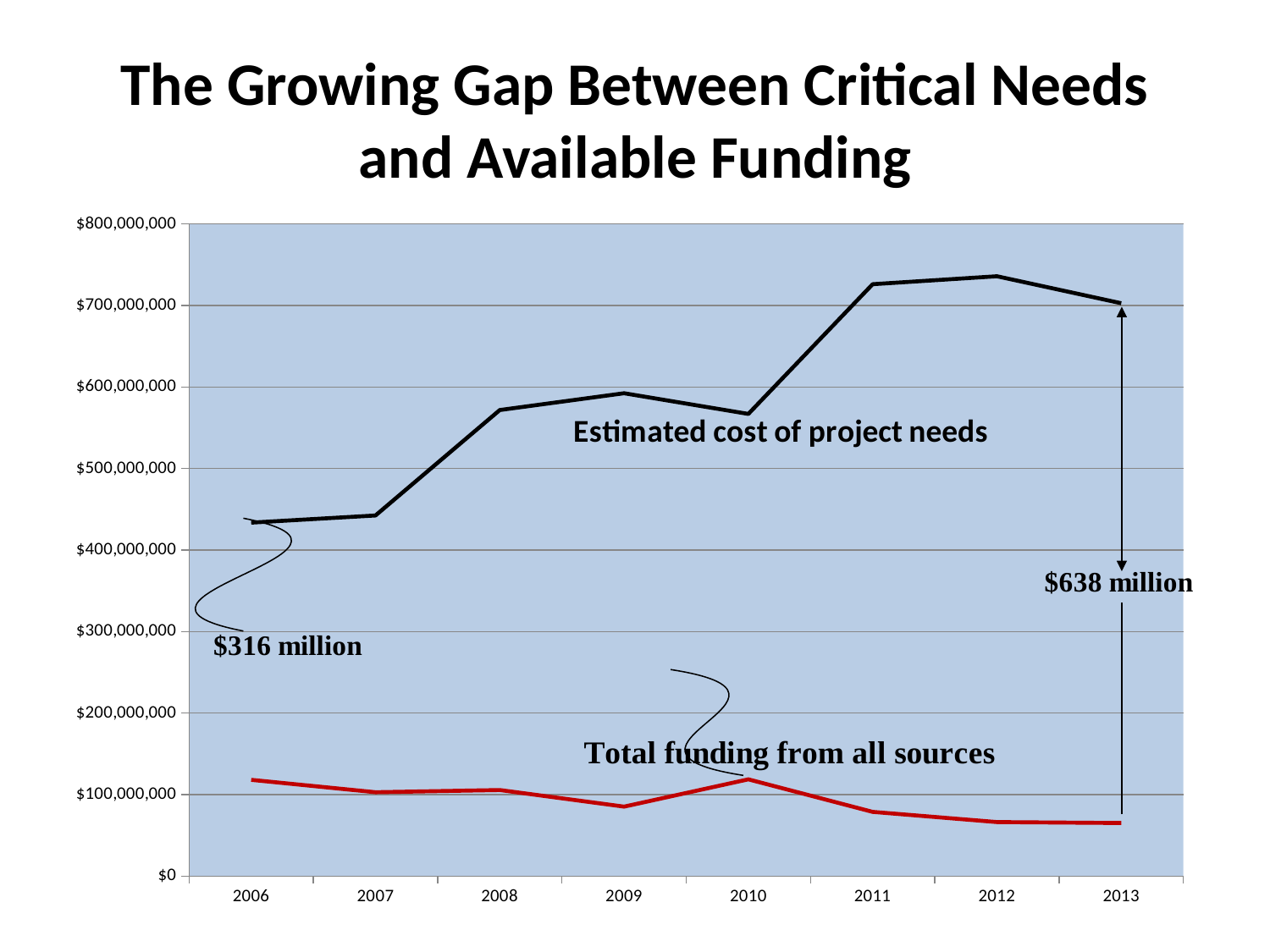
How many years are plotted along the x axis? 8 Does the total funding from all sources generally rise or fall from 2006 to 2013? fall Which is larger: the estimated cost of project needs in 2006 or in 2013? 2013 What kind of chart is shown on the slide? line chart Does the estimated cost of project needs generally rise or fall from 2006 to 2013? rise How many data series are plotted on the chart? 2 Is the estimated cost of project needs in 2010 greater or less than $600,000,000? less What is the gap between estimated cost of project needs and total funding labelled as for 2013? $638 million Is the estimated cost of project needs in 2011 greater or less than $700,000,000? greater Is the total funding from all sources in 2009 greater or less than $100,000,000? less What is the gap between estimated cost of project needs and total funding labelled as for 2006? $316 million By how much did the labelled gap grow from 2006 ($316 million) to 2013 ($638 million)? $322 million